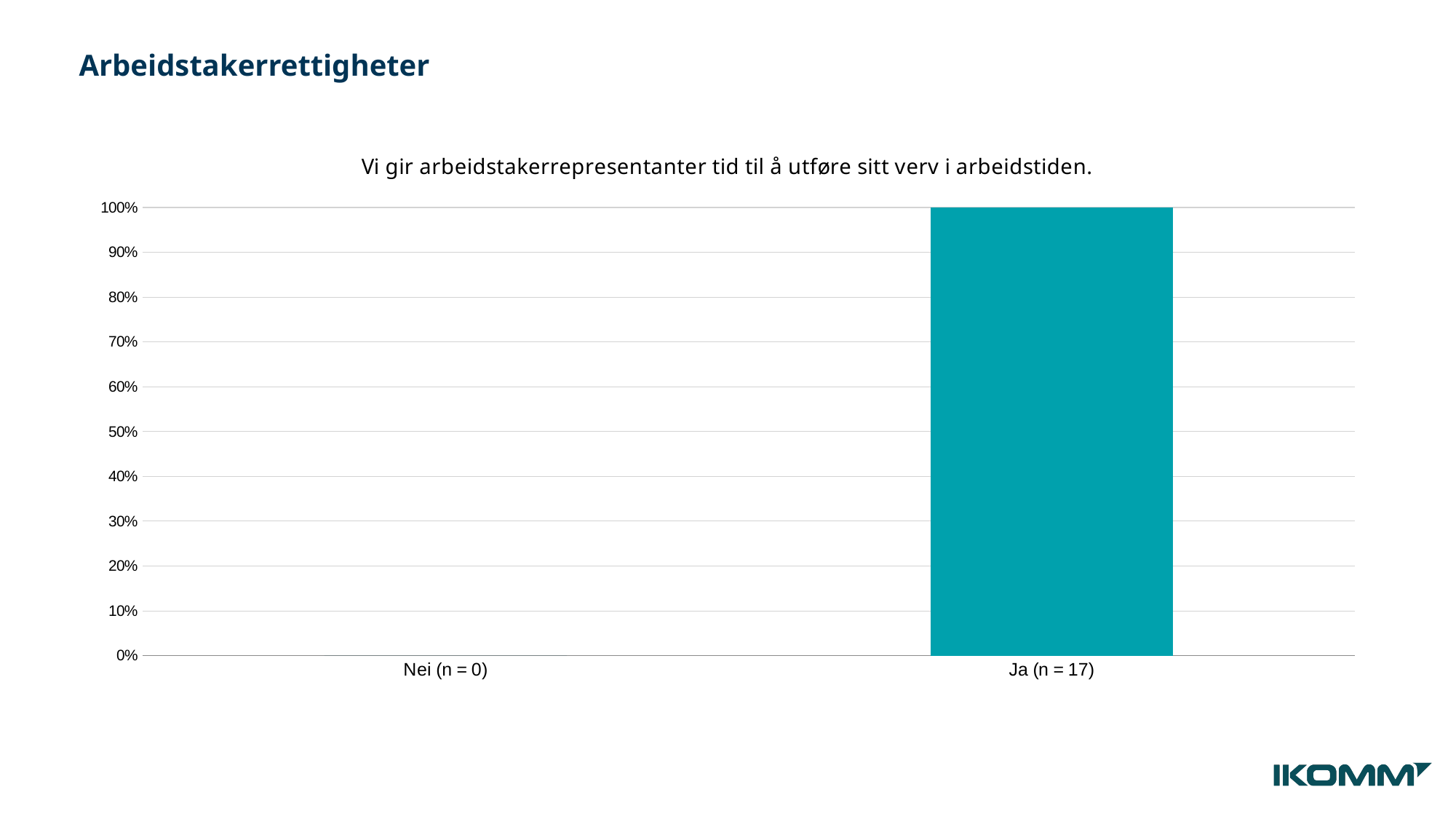
Is the value for Ja (n = 17) greater or less than 50%? greater Which category has the highest value? Ja (n = 17) Which category has the lowest value? Nei (n = 0) What is the difference between the value for Ja (n = 17) and the value for Nei (n = 0)? 100% How many categories are shown on the x axis of the chart? 2 What is the highest value shown on the y axis? 100% What is the value for Nei (n = 0)? 0% What is the value for Ja (n = 17)? 100% What is the title of the chart? Vi gir arbeidstakerrepresentanter tid til å utføre sitt verv i arbeidstiden. What kind of chart is shown on the slide? bar chart How many respondents answered Ja according to the category label? 17 Which is larger, the value for Ja (n = 17) or the value for Nei (n = 0)? Ja (n = 17)